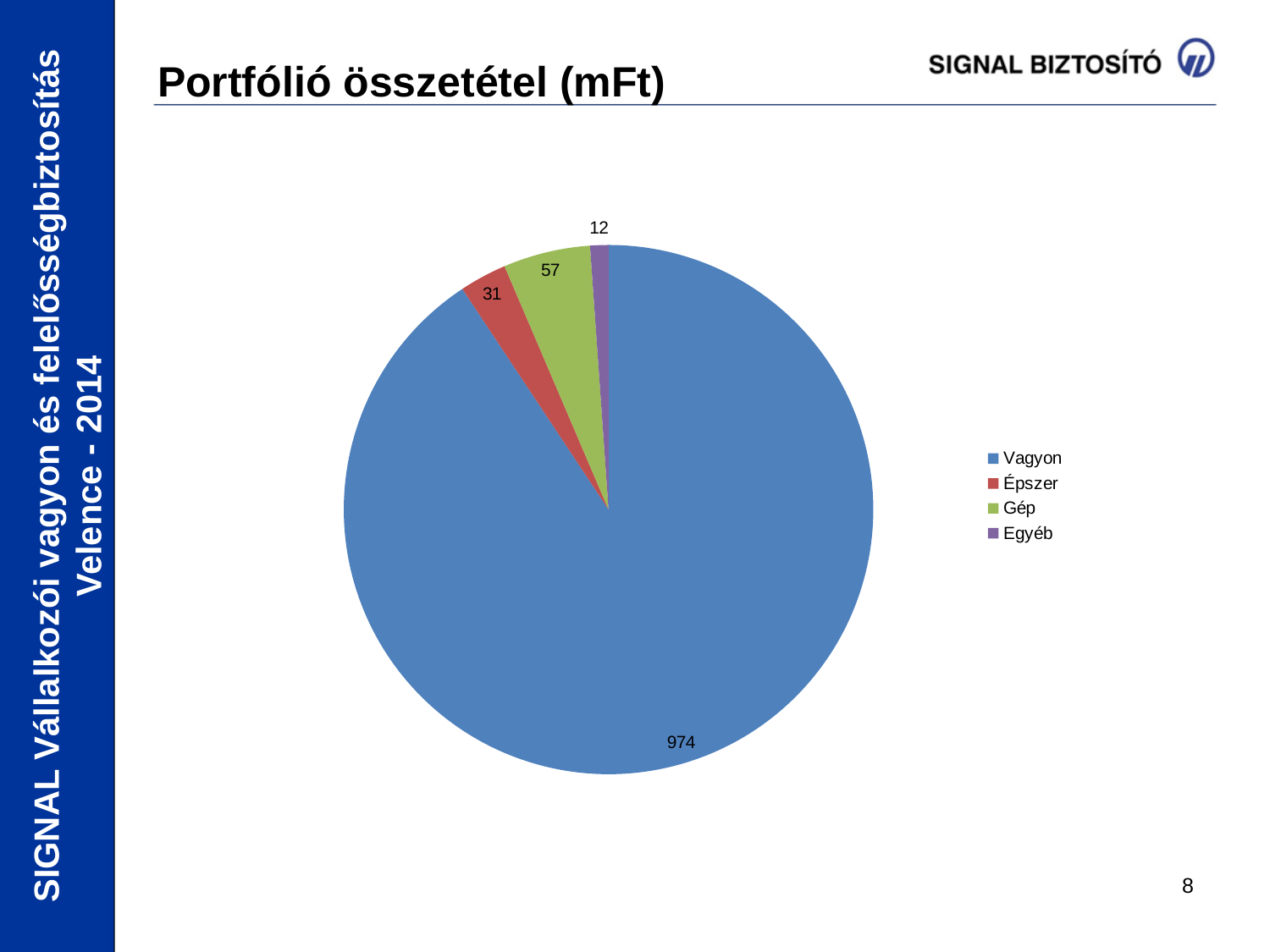
How many categories are shown in the pie chart? 4 What is the difference between the values for Gép and Épszer? 26 What is the value for Épszer in the pie chart? 31 Which category has the smallest slice of the pie chart? Egyéb What is the value for Gép in the pie chart? 57 What is the difference between the values for Vagyon and Gép? 917 What is the title of the chart on the slide? Portfólió összetétel (mFt) Which is larger, the value for Gép or the value for Épszer? Gép What is the value for Vagyon in the pie chart? 974 Which category has the largest slice of the pie chart? Vagyon What is the value for Egyéb in the pie chart? 12 What kind of chart is shown on the slide? Pie chart